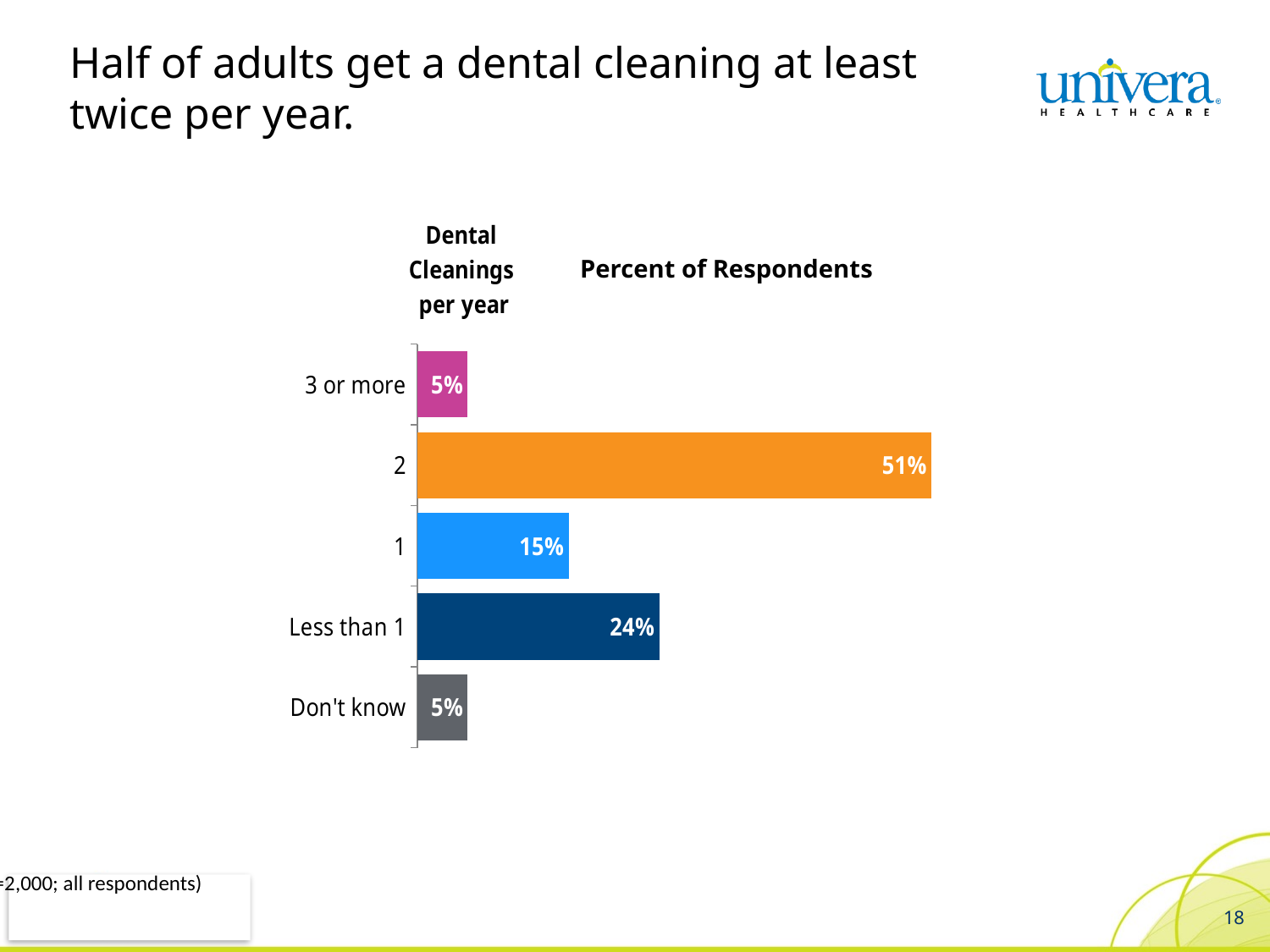
What is the difference in percent of respondents between 'Less than 1' and '1'? 9% Which category has the highest percent of respondents? 2 What is the title of the chart's value axis? Percent of Respondents What kind of chart is shown on the slide? Bar chart What percent of respondents get 1 dental cleaning per year? 15% What percent of respondents get less than 1 dental cleaning per year? 24% What percent of respondents answered 'Don't know'? 5% What is the difference in percent of respondents between the '2' and 'Less than 1' categories? 27% Which is larger: the percent for '1' cleaning per year or for 'Less than 1'? Less than 1 What is the combined percent of respondents for '3 or more' and '2' cleanings per year? 56% What percent of respondents get 2 dental cleanings per year? 51% How many categories are shown in the chart? 5